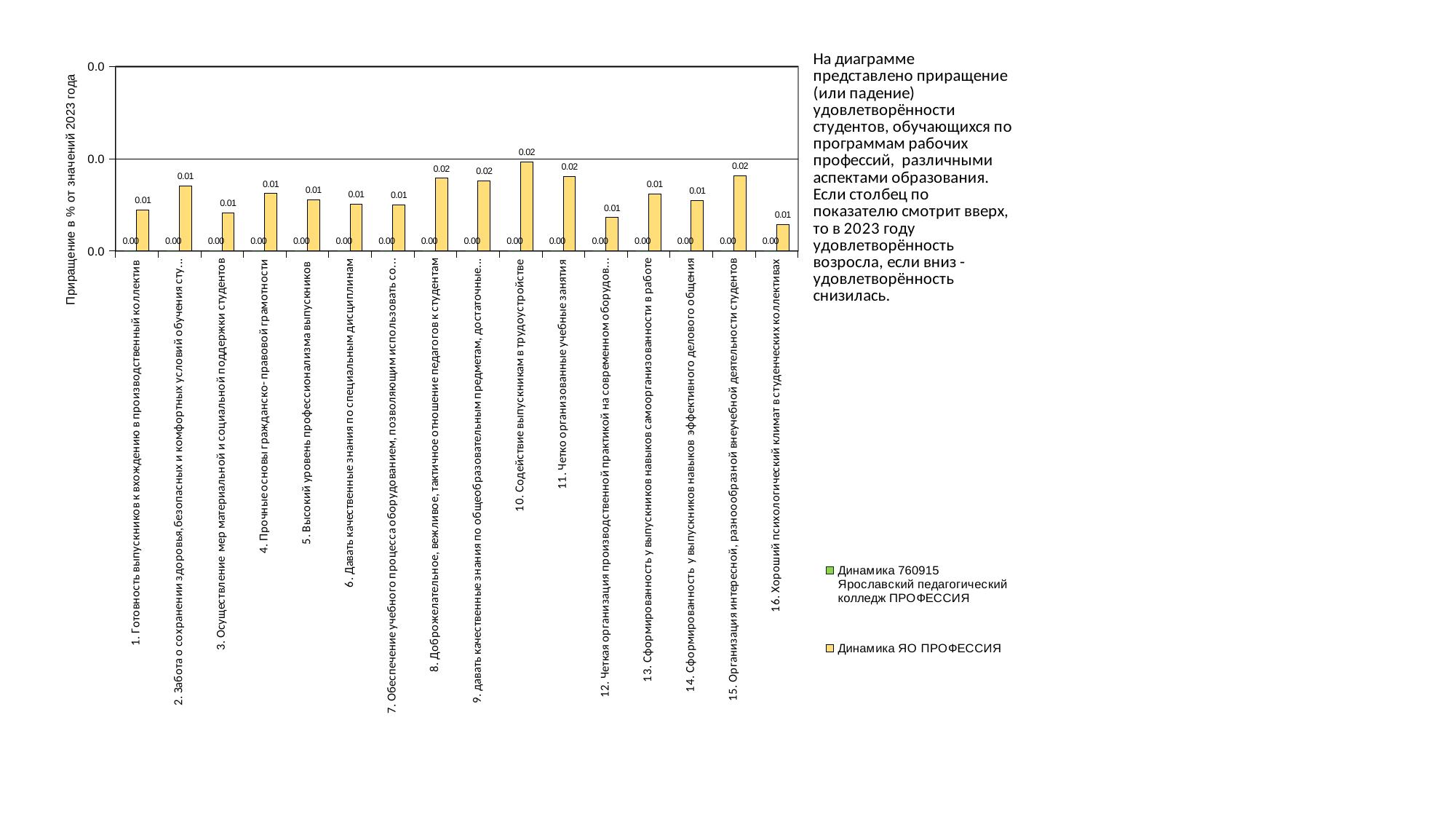
What is the value of the 'Динамика ЯО ПРОФЕССИЯ' series for category '16. Хороший психологический климат в студенческих коллективах'? 0.01 What is the value of the 'Динамика ЯО ПРОФЕССИЯ' series for category '11. Четко организованные учебные занятия'? 0.02 How many series does the legend list? 2 What is the value of the 'Динамика ЯО ПРОФЕССИЯ' series for category '10. Содействие выпускникам в трудоустройстве'? 0.02 Which is larger for the 'Динамика ЯО ПРОФЕССИЯ' series: category 10 (Содействие выпускникам в трудоустройстве) or category 1 (Готовность выпускников к вхождению в производственный коллектив)? category 10 (Содействие выпускникам в трудоустройстве) What is the value of the 'Динамика 760915 Ярославский педагогический колледж ПРОФЕССИЯ' series for category '5. Высокий уровень профессионализма выпускников'? 0.00 What colour are the bars of the 'Динамика ЯО ПРОФЕССИЯ' series? yellow What is the value of the 'Динамика ЯО ПРОФЕССИЯ' series for category '1. Готовность выпускников к вхождению в производственный коллектив'? 0.01 What type of chart is shown on the slide? bar chart How many categories are plotted along the x axis? 16 What is the difference between the 'Динамика ЯО ПРОФЕССИЯ' values for category 15 (Организация интересной, разноообразной внеучебной деятельности студентов) and category 14 (Сформированность у выпускников навыков эффективного делового общения)? 0.01 What is the title of the vertical axis? Приращение в % от значений 2023 года